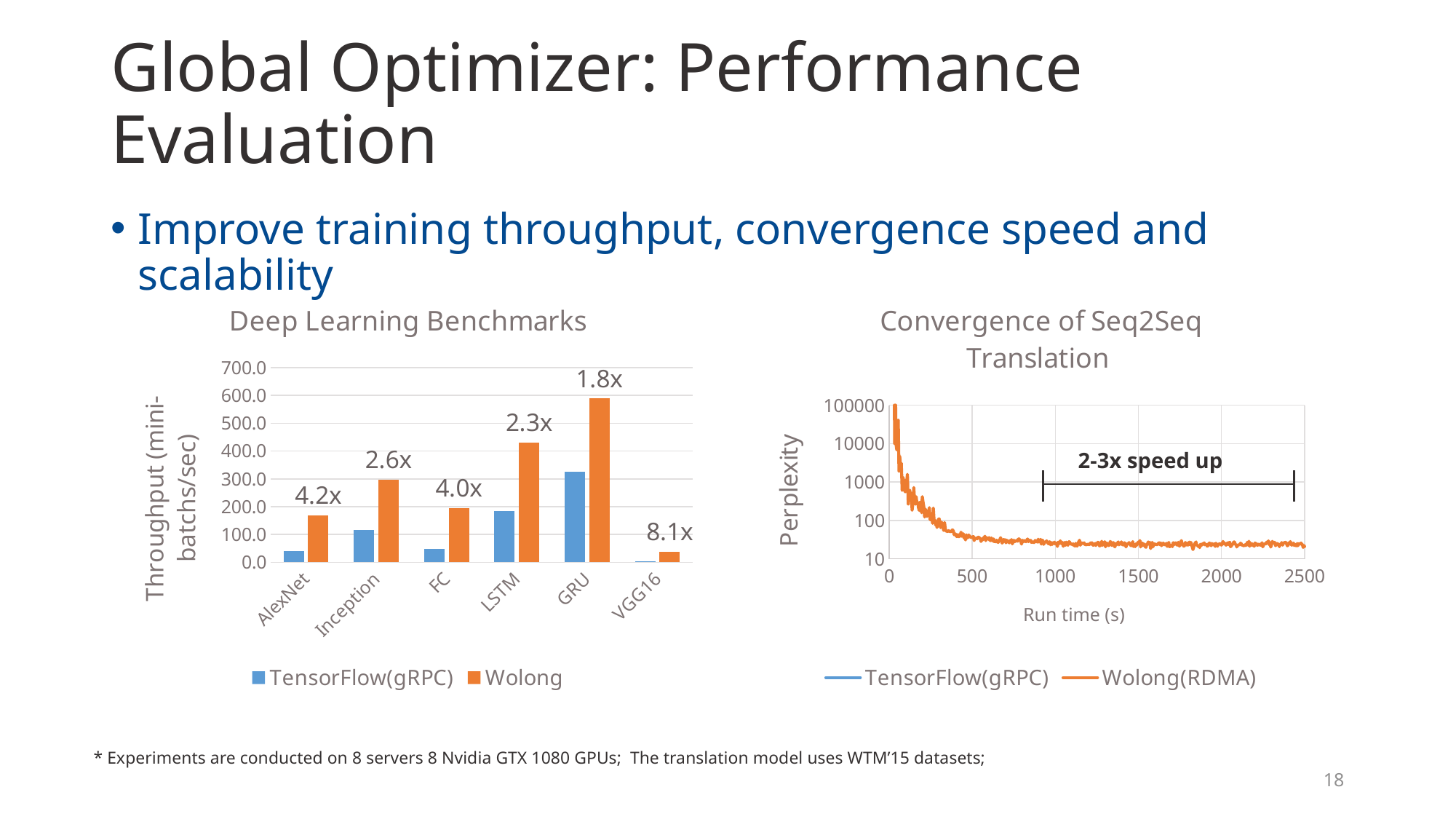
What kind of chart is the Convergence of Seq2Seq Translation chart? line chart In the Deep Learning Benchmarks chart, is the TensorFlow(gRPC) throughput for AlexNet greater or less than 100.0? less How many series does the legend of the Deep Learning Benchmarks chart list? 2 In the Deep Learning Benchmarks chart, what speedup label is shown above the VGG16 bars? 8.1x In the Deep Learning Benchmarks chart, which benchmark has the highest Wolong throughput? GRU What kind of chart is the Deep Learning Benchmarks chart? bar chart In the Convergence of Seq2Seq Translation chart, does perplexity rise or fall as run time increases? fall In the Deep Learning Benchmarks chart, what speedup label is shown above the AlexNet bars? 4.2x In the Deep Learning Benchmarks chart, which benchmark has the lowest Wolong throughput? VGG16 In the Deep Learning Benchmarks chart, which series has the larger throughput for GRU, TensorFlow(gRPC) or Wolong? Wolong In the Deep Learning Benchmarks chart, is the Wolong throughput for GRU greater or less than 500.0? greater How many benchmark categories are shown on the x axis of the Deep Learning Benchmarks chart? 6